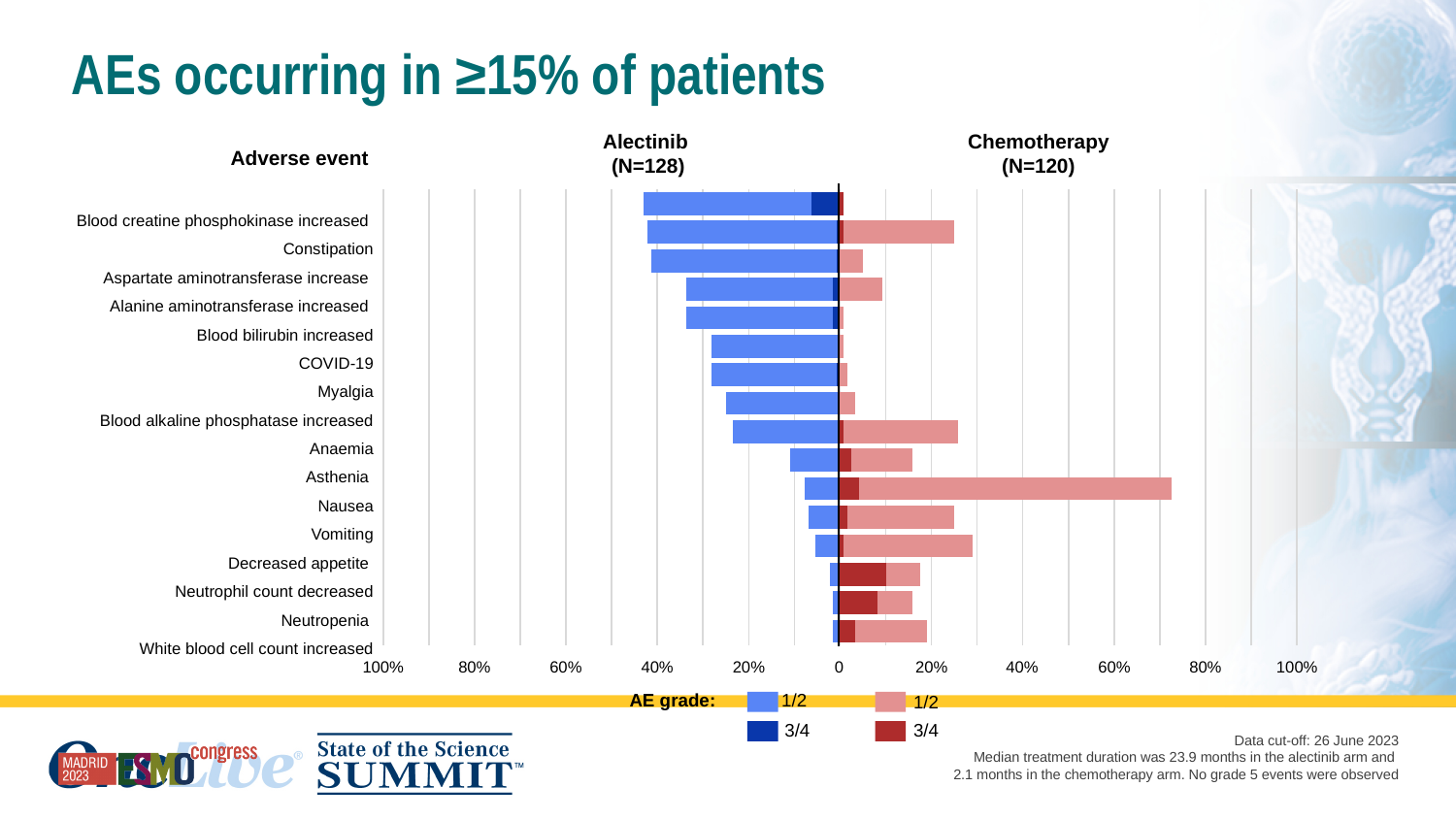
How many entries does the AE grade legend list? 4 Which adverse event has the highest chemotherapy value? Nausea What kind of chart is shown on the slide? bar chart How many adverse events are listed on the chart? 16 Is the chemotherapy value for Nausea greater or less than 60%? greater What is the number of patients in the alectinib arm shown in the chart header? N=128 Is the alectinib value for White blood cell count increased greater or less than 20%? less Is the alectinib value for Neutropenia greater or less than 20%? less What is the title of the slide? AEs occurring in ≥15% of patients For Nausea, which arm has the larger value, alectinib or chemotherapy? Chemotherapy